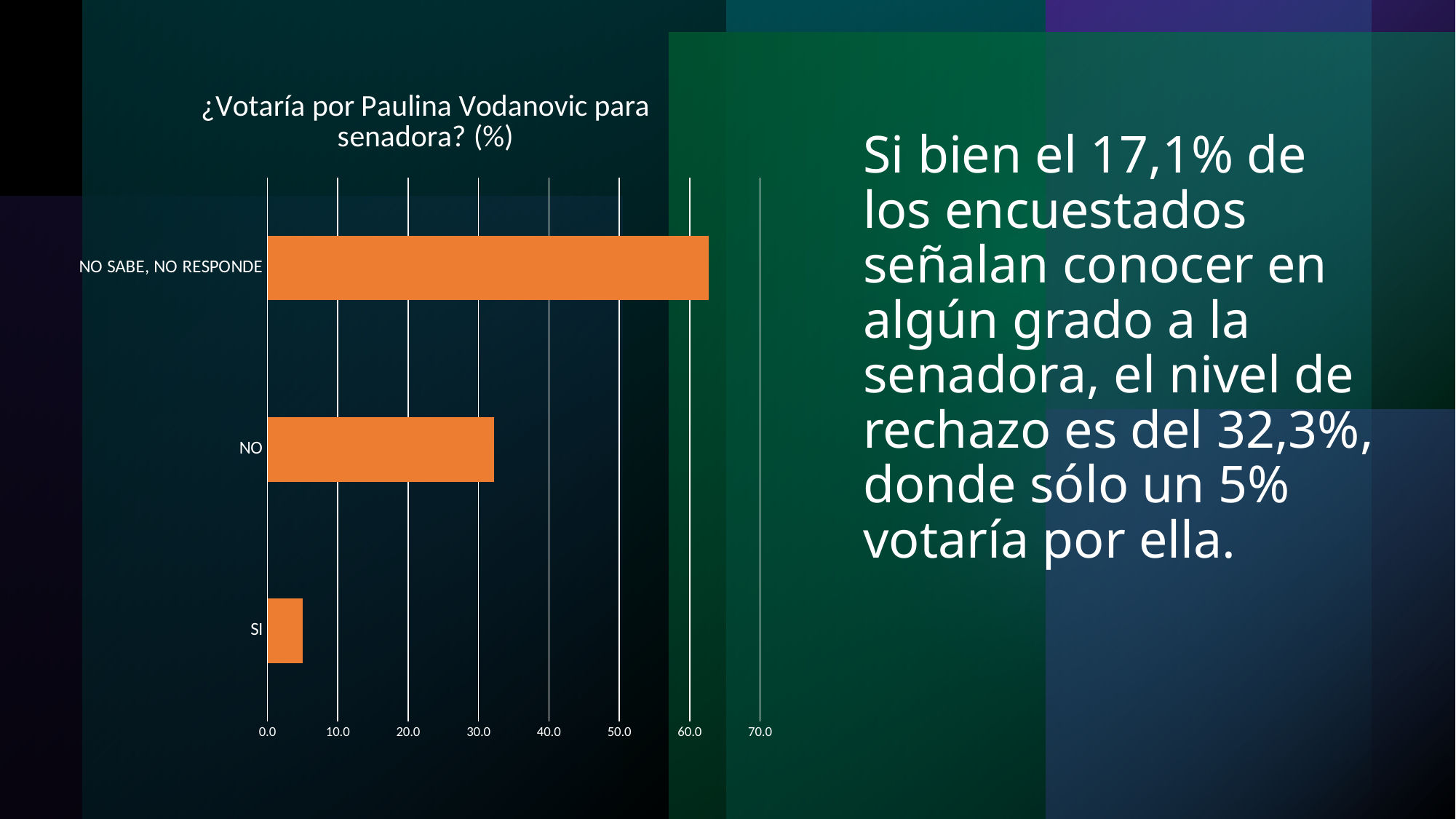
Is the value for NO greater or less than 40.0? less Which category has the highest value? NO SABE, NO RESPONDE Is the value for NO greater or less than 30.0? greater Which category has the lowest value? SI Is the value for NO SABE, NO RESPONDE greater or less than 60.0? greater How many categories does the chart show? 3 What colour are the bars in the chart? orange What is the title of the chart? ¿Votaría por Paulina Vodanovic para senadora? (%) Which is larger, the value for NO or the value for SI? NO What kind of chart is shown on the slide? bar chart